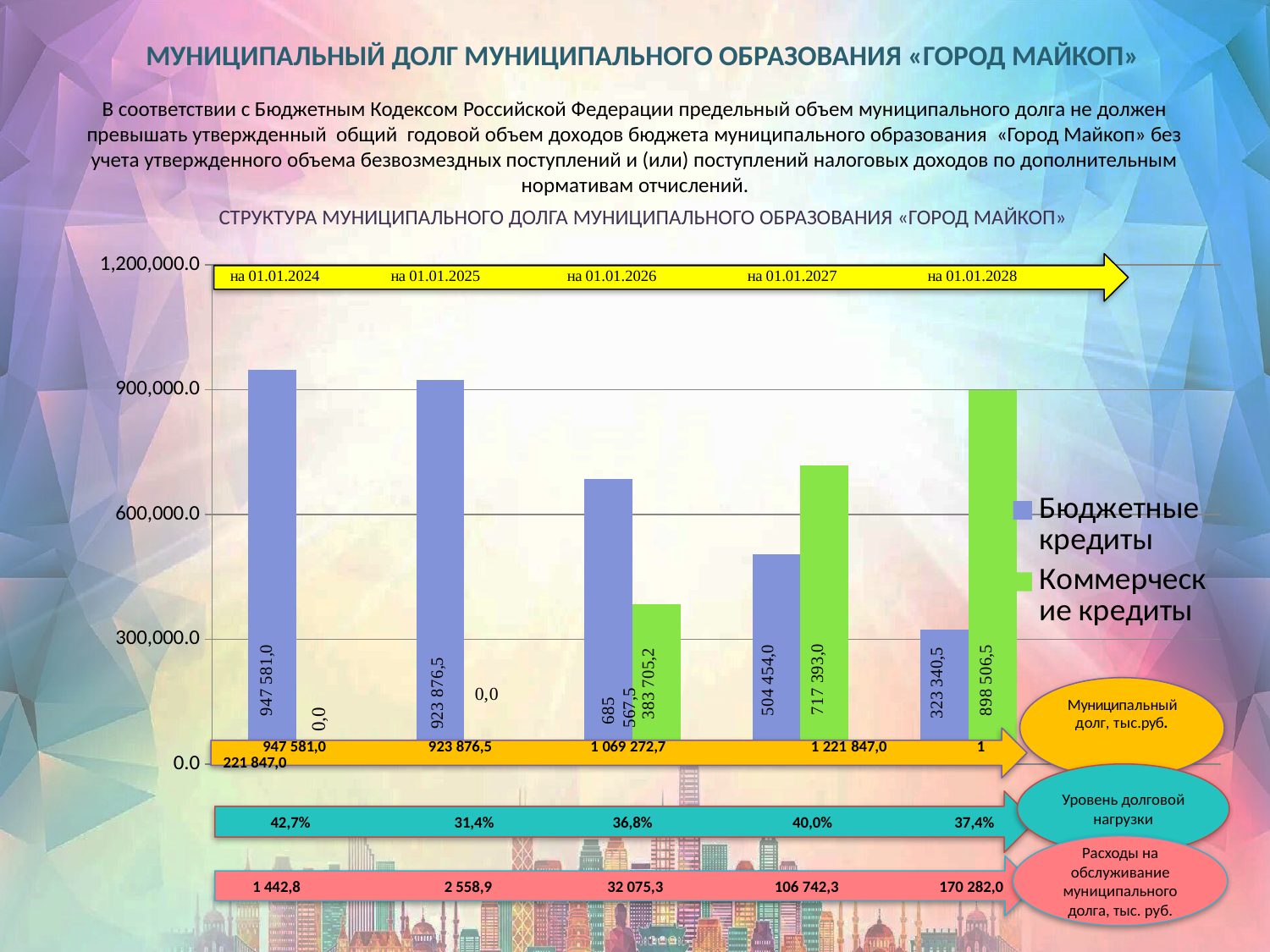
Do the values of Бюджетные кредиты rise or fall from 01.01.2024 to 01.01.2028? fall What kind of chart is shown on the slide? bar chart How many dates (categories) are plotted on the chart? 5 On which date is the value of Бюджетные кредиты the highest? на 01.01.2024 What is the value of Коммерческие кредиты на 01.01.2027? 717 393,0 How many series does the chart legend list? 2 On which date is the value of Коммерческие кредиты the highest? на 01.01.2028 Is the value of Бюджетные кредиты на 01.01.2026 greater or less than 600,000.0? greater What is the difference between Бюджетные кредиты на 01.01.2024 and на 01.01.2025? 23 704,5 What is the value of Бюджетные кредиты на 01.01.2024? 947 581,0 Which is larger на 01.01.2027: Бюджетные кредиты or Коммерческие кредиты? Коммерческие кредиты What is the value of Бюджетные кредиты на 01.01.2028? 323 340,5